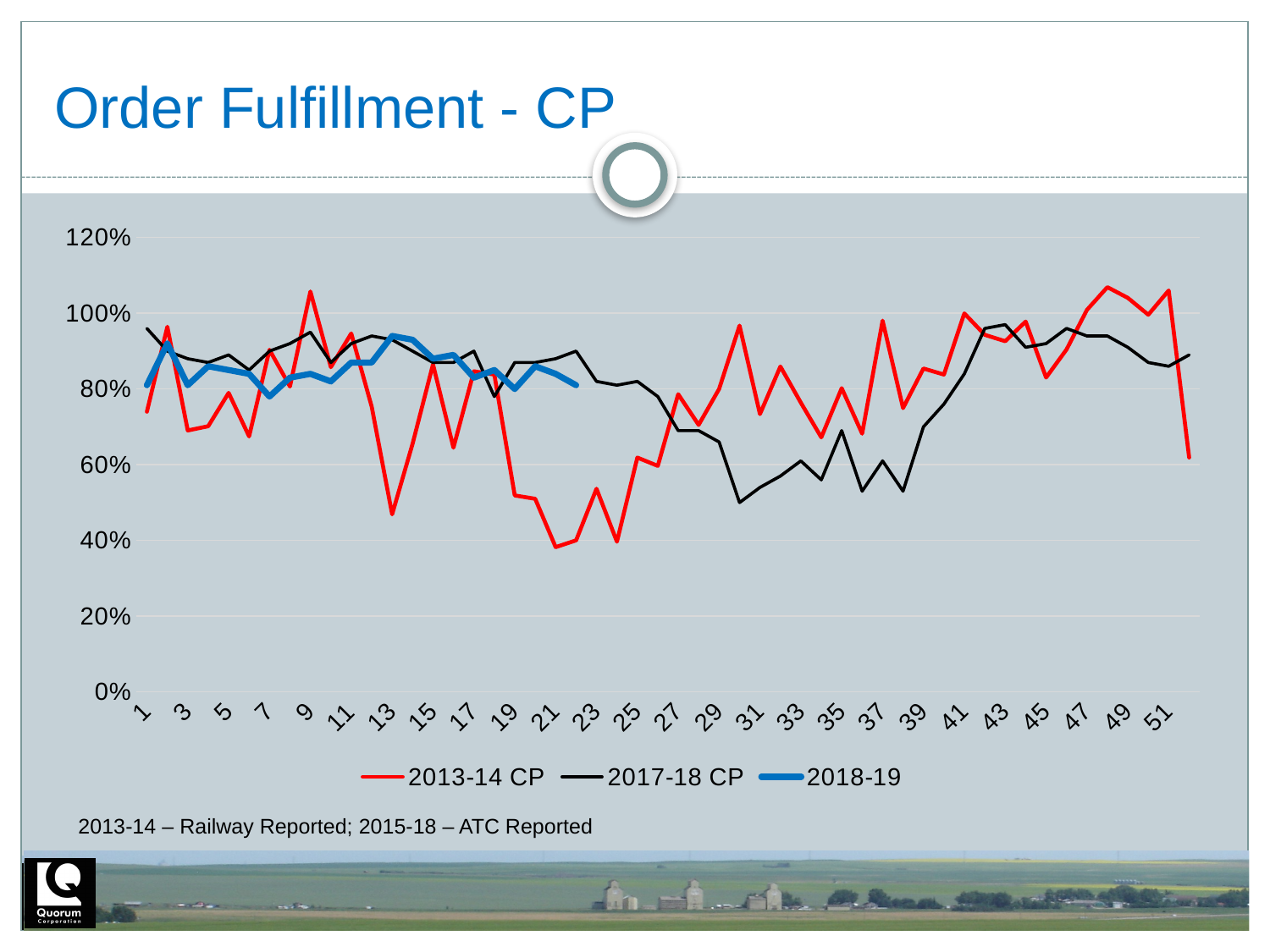
Is the value for 2017-18 CP at week 1 greater or less than 80%? greater Is the value for 2013-14 CP at week 52 greater or less than 80%? less Which colour is used for the 2018-19 series? blue At week 13, which series has the higher value, 2013-14 CP or 2017-18 CP? 2017-18 CP What kind of chart is shown on the slide? line chart Is the value for 2017-18 CP at week 31 greater or less than 60%? less What is the title of the chart? Order Fulfillment - CP At week 31, which series has the higher value, 2013-14 CP or 2017-18 CP? 2013-14 CP What is the highest value shown on the y axis? 120% How many series does the legend list? 3 Does the 2017-18 CP series rise or fall between week 31 and week 41? rise